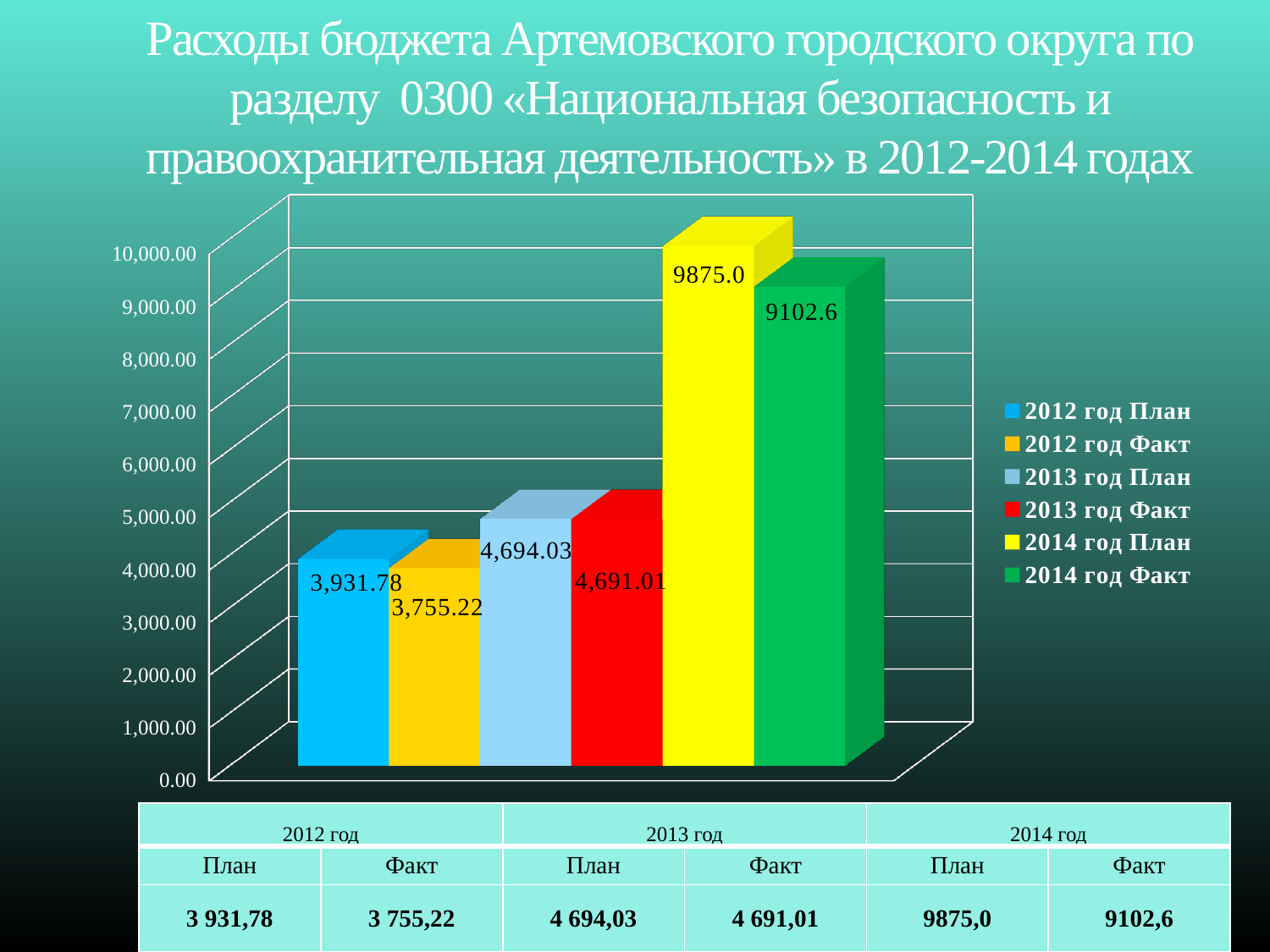
Which is larger, 2013 год План or 2012 год План? 2013 год План What is the difference between 2012 год План and 2012 год Факт? 176.56 Which series has the highest value? 2014 год План What is the value for 2012 год Факт? 3,755.22 What kind of chart is shown on the slide? bar chart What is the value for 2014 год Факт? 9102.6 Which series has the lowest value? 2012 год Факт What is the difference between 2014 год План and 2014 год Факт? 772.4 What is the value for 2013 год План? 4,694.03 What is the value for 2012 год План? 3,931.78 How many series does the legend list? 6 Is the value for 2012 год Факт greater or less than 4,000.00? less